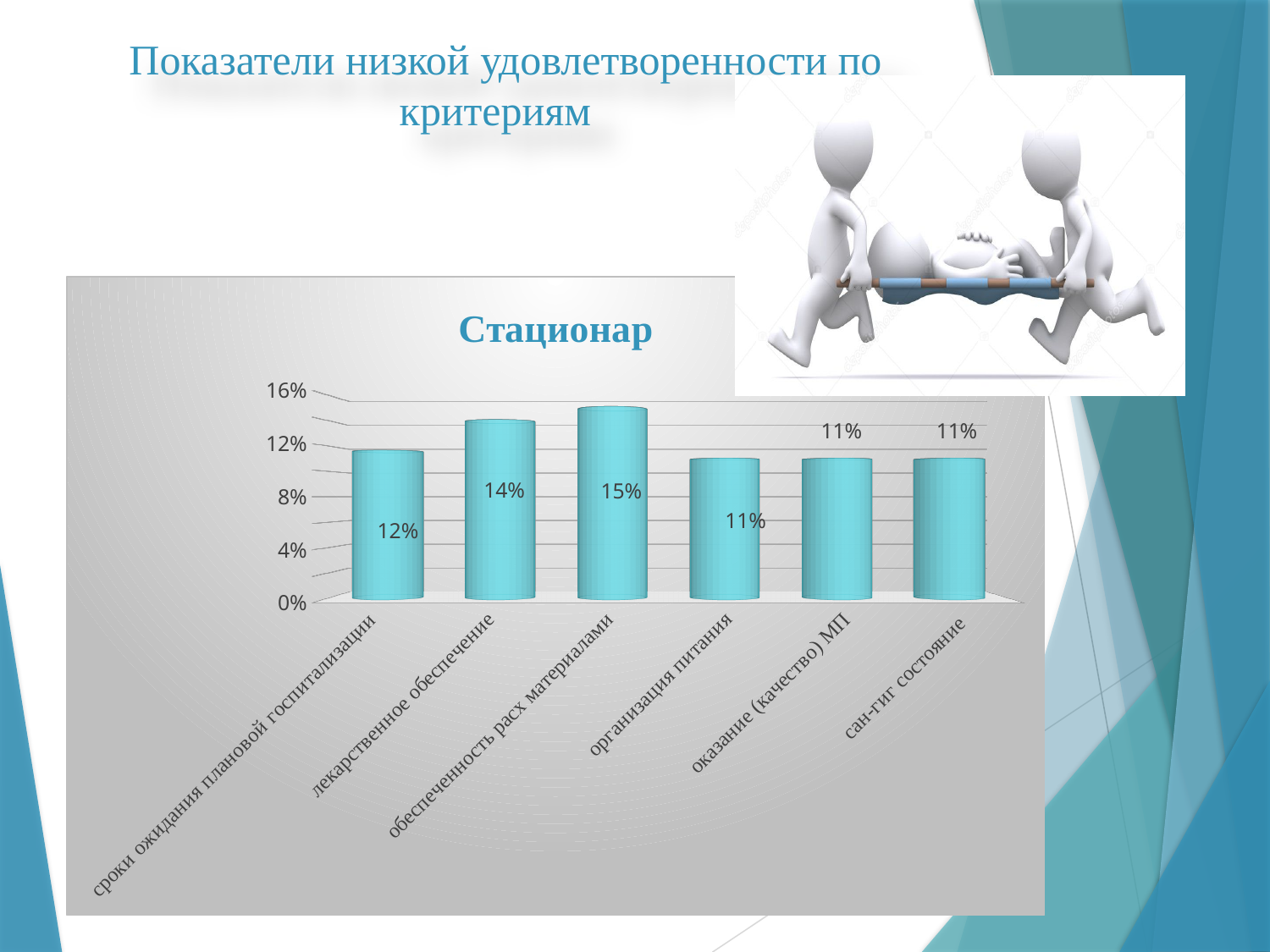
What is the title of the chart on the slide? Стационар Which category has the highest value in the Стационар chart? обеспеченность расх материалами What is the difference between the values for обеспеченность расх материалами and оказание (качество) МП? 4% What is the difference between the values for лекарственное обеспечение and сроки ожидания плановой госпитализации? 2% Is the value for обеспеченность расх материалами greater or less than 12%? greater What is the value for сан-гиг состояние in the Стационар chart? 11% What kind of chart is shown on the slide? bar chart How many categories are shown in the Стационар chart? 6 What is the value for организация питания in the Стационар chart? 11% What is the value for лекарственное обеспечение in the Стационар chart? 14% What is the value for сроки ожидания плановой госпитализации in the Стационар chart? 12% Which is larger: the value for лекарственное обеспечение or the value for организация питания? лекарственное обеспечение